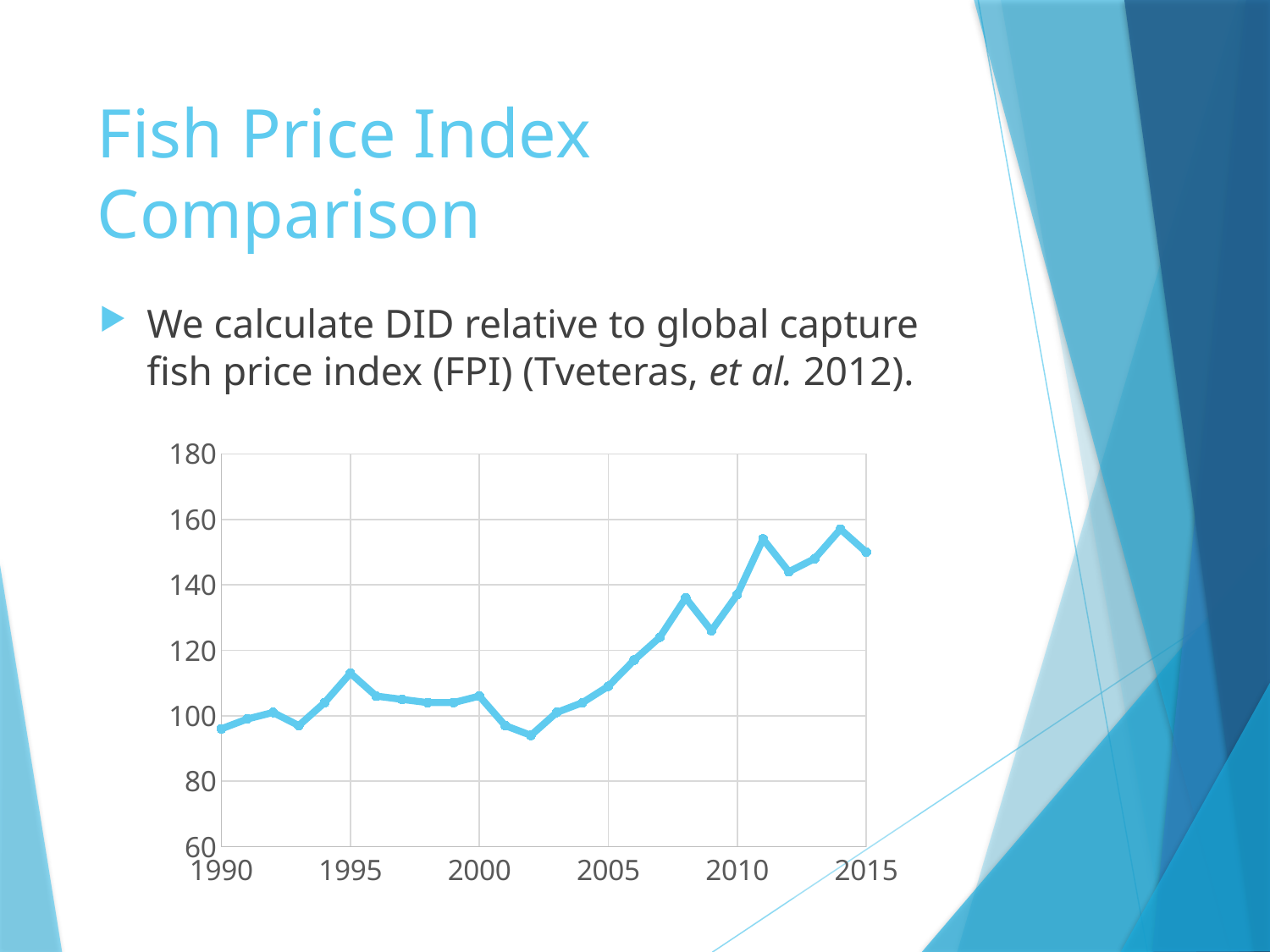
Which year has the lowest value on the chart? 2002 What kind of chart is shown on the slide? line chart Is the value for 2011 greater or less than 140? greater Overall, do the values rise or fall from 1990 to 2015? rise Is the value for 2015 greater or less than 140? greater Is the value for 2008 greater or less than 140? less Which is larger, the value for 1995 or the value for 1993? 1995 Do the values rise or fall between 2000 and 2002? fall Which is larger, the value for 2011 or the value for 2009? 2011